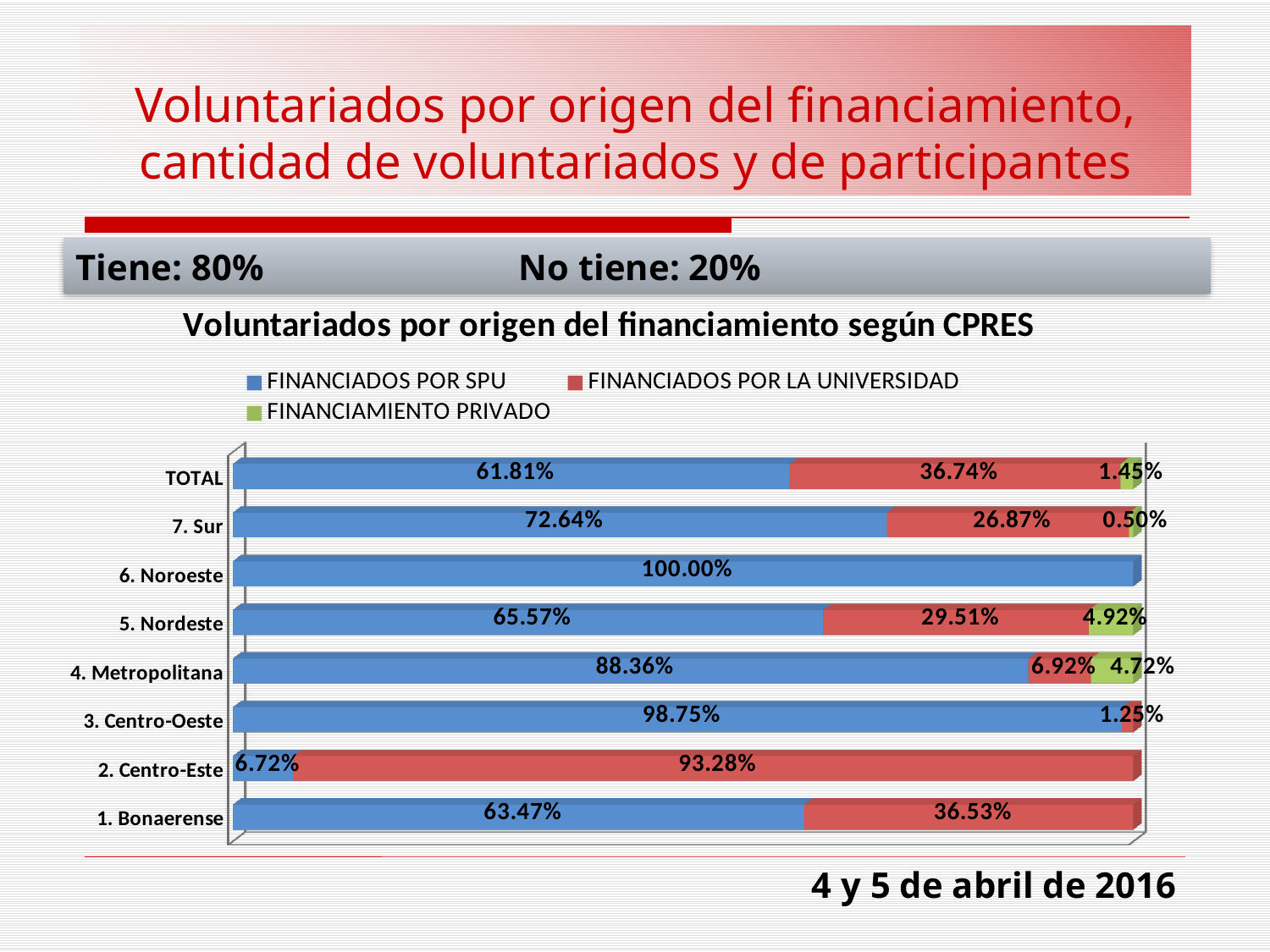
What is the title of the chart? Voluntariados por origen del financiamiento según CPRES What type of chart is shown on the slide? Stacked bar chart What is the FINANCIADOS POR SPU value for 7. Sur? 72.64% Which category has the highest FINANCIADOS POR SPU value? 6. Noroeste What is the FINANCIADOS POR SPU value for TOTAL? 61.81% How many series does the legend list? 3 What is the FINANCIAMIENTO PRIVADO value for 5. Nordeste? 4.92% How many categories are shown on the vertical axis of the chart? 8 Which category has the lowest FINANCIADOS POR SPU value? 2. Centro-Este What is the FINANCIADOS POR LA UNIVERSIDAD value for 2. Centro-Este? 93.28% What is the difference between the FINANCIADOS POR SPU values for 4. Metropolitana and 1. Bonaerense? 24.89% Which is larger, the FINANCIADOS POR LA UNIVERSIDAD value for 7. Sur or for 5. Nordeste? 5. Nordeste